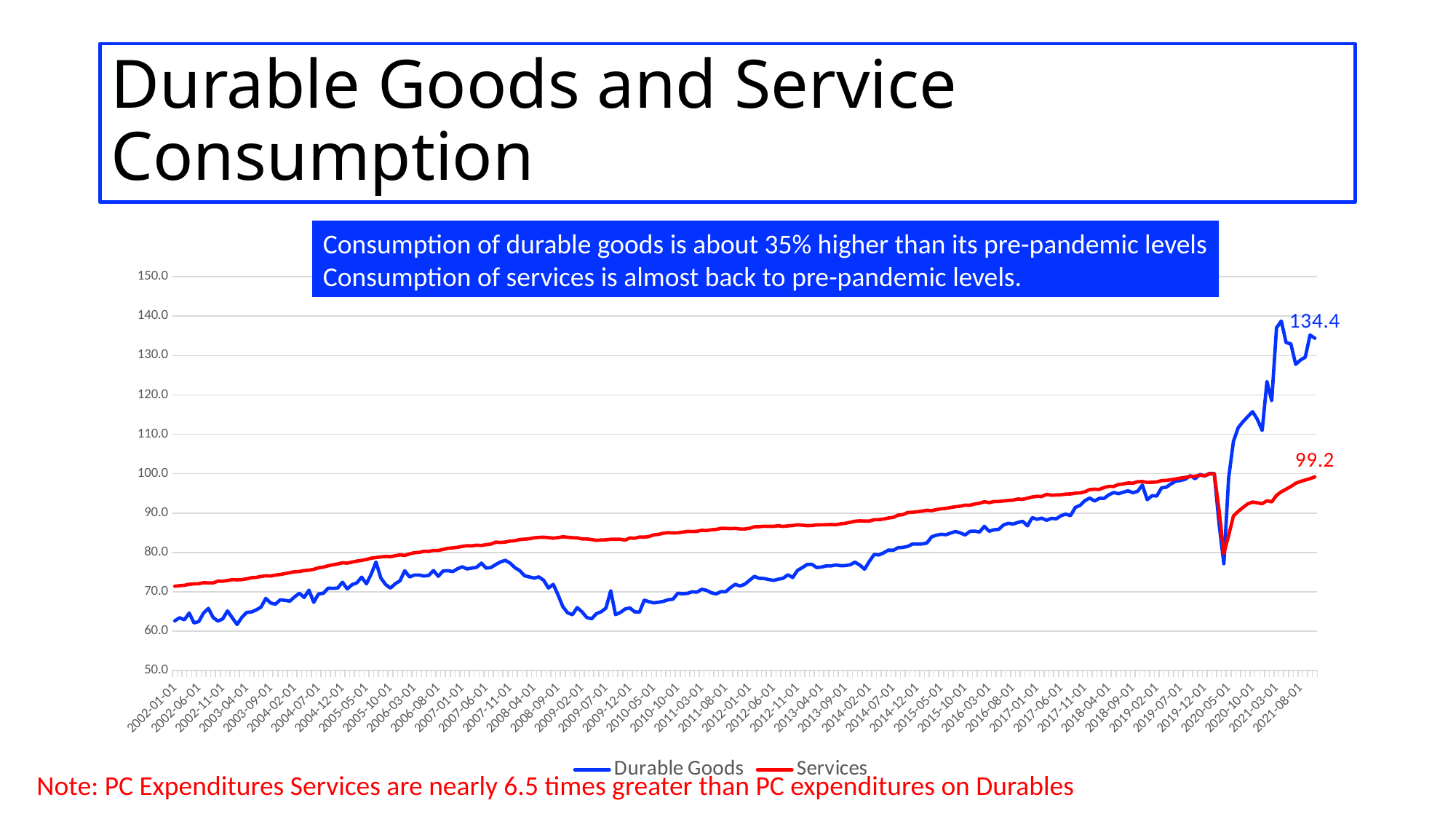
What is the final labelled value of the Services series? 99.2 At the end of the chart, which series has the higher value, Durable Goods or Services? Durable Goods Is the value of Services at 2002-01-01 greater or less than 80? less What colour is the Services line in the chart? red What kind of chart is shown on the slide? line chart How many series does the legend list? 2 What is the difference between the final labelled values of Durable Goods (134.4) and Services (99.2)? 35.2 Is the value of Durable Goods at 2009-02-01 greater or less than 70? less Does the Services series generally rise or fall from 2002 to 2019? rise What is the final labelled value of the Durable Goods series? 134.4 Is the value of Durable Goods at 2002-01-01 greater or less than 70? less